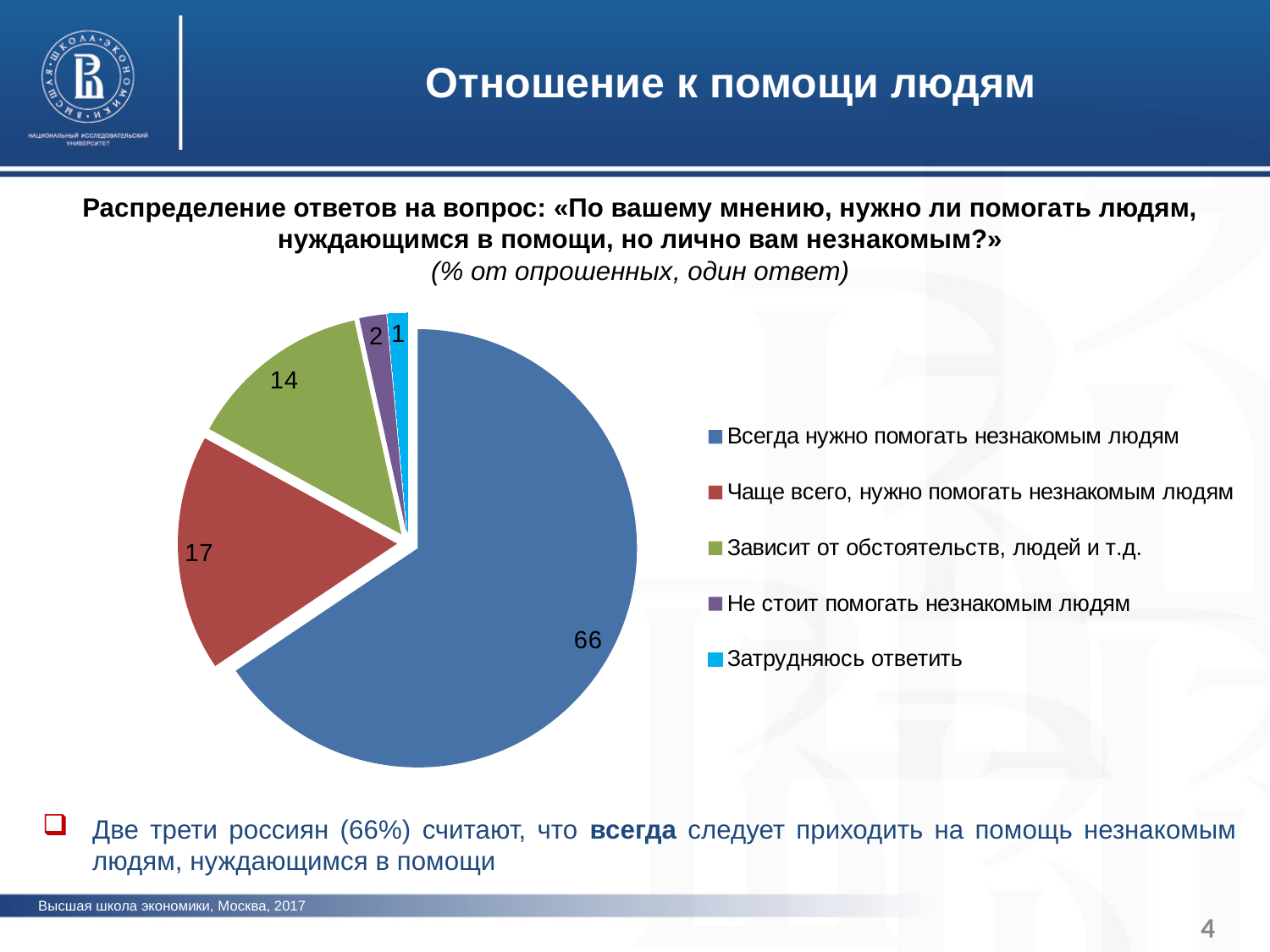
What is the value for «Чаще всего, нужно помогать незнакомым людям»? 17 What is the value for «Не стоит помогать незнакомым людям»? 2 What is the value for «Всегда нужно помогать незнакомым людям»? 66 How many slices does the pie chart have? 5 What kind of chart is shown on the slide? pie chart Which answer option has the smallest share of the pie? Затрудняюсь ответить What colour is the slice for «Зависит от обстоятельств, людей и т.д.»? green What is the value for «Зависит от обстоятельств, людей и т.д.»? 14 Which answer option has the largest share of the pie? Всегда нужно помогать незнакомым людям What is the difference between the values for «Всегда нужно помогать незнакомым людям» and «Чаще всего, нужно помогать незнакомым людям»? 49 Which is larger: the value for «Чаще всего, нужно помогать незнакомым людям» or for «Зависит от обстоятельств, людей и т.д.»? Чаще всего, нужно помогать незнакомым людям What is the value for «Затрудняюсь ответить»? 1